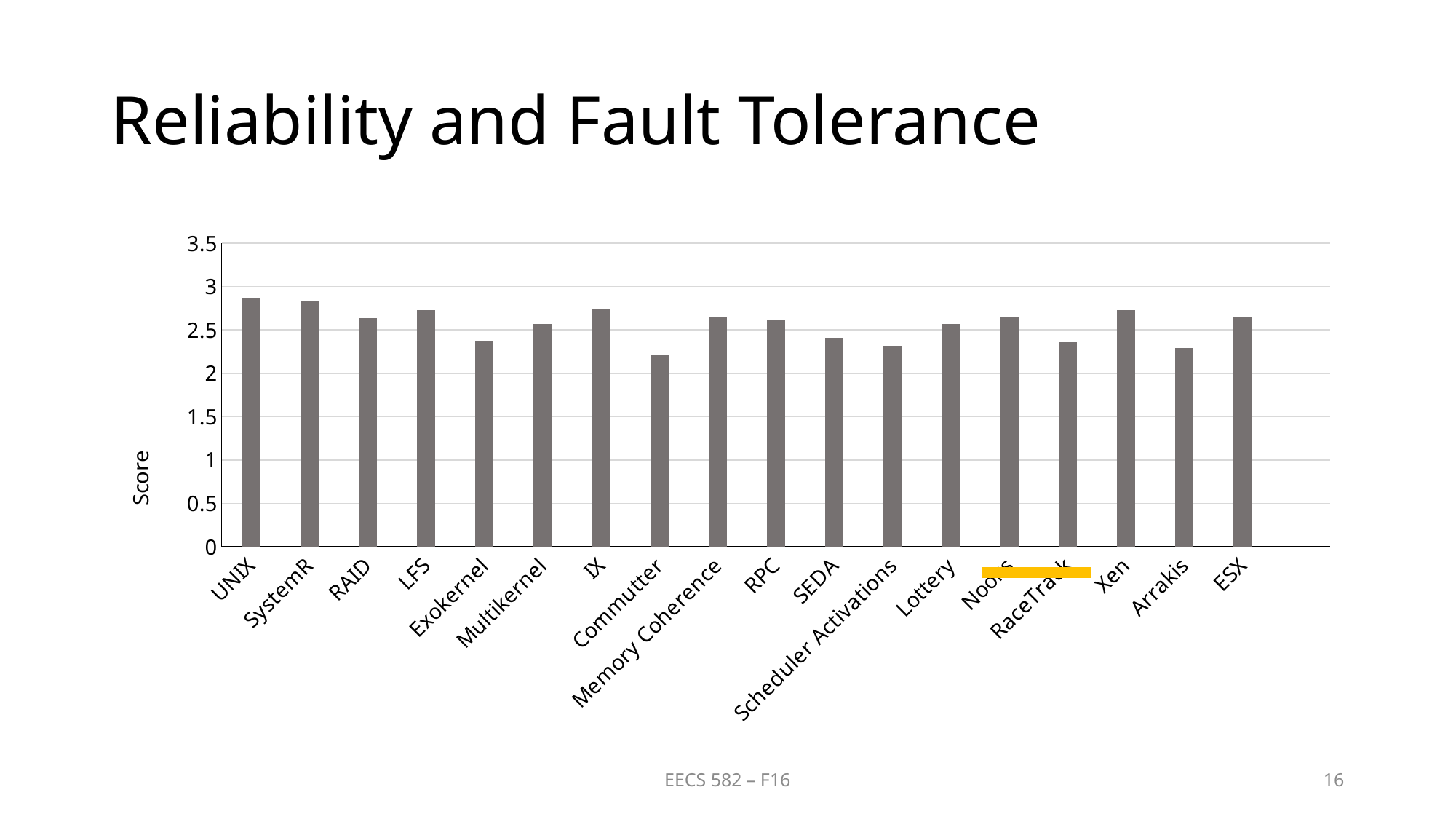
What is the label on the vertical axis of the chart? Score Which has the higher score, LFS or Exokernel? LFS Which has the higher score, Xen or Arrakis? Xen Which category has the lowest score in the chart? Commutter Is the score for Exokernel greater or less than 2.5? less Which has the higher score, UNIX or Commutter? UNIX What is the title of the slide containing the chart? Reliability and Fault Tolerance Is the score for UNIX greater or less than 2.5? greater What kind of chart is shown on the slide? bar chart How many bars (categories) does the chart show? 18 Is the score for Arrakis greater or less than 2? greater